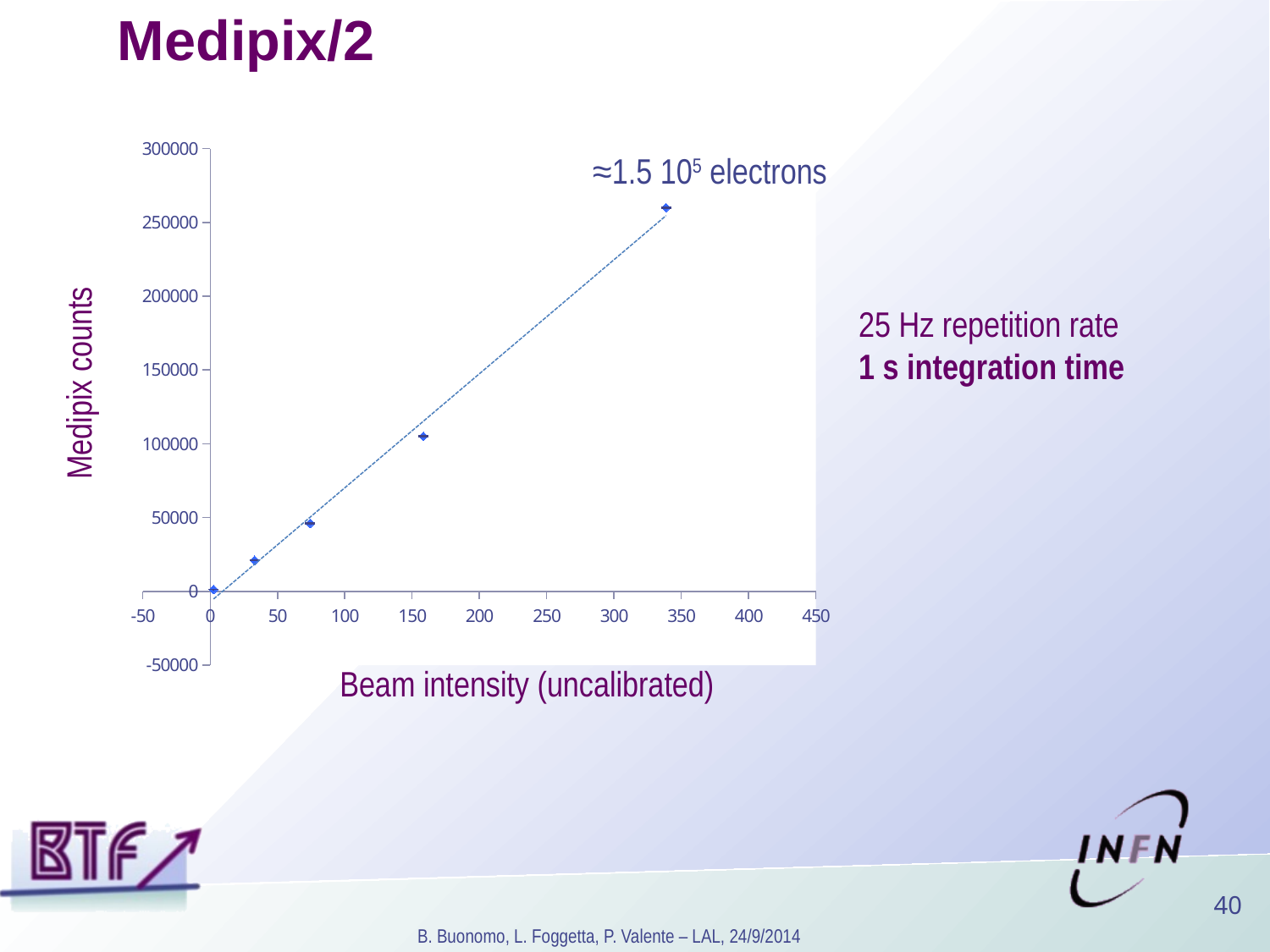
What kind of chart is shown on the slide? scatter chart Is the Medipix counts value for the rightmost data point greater or less than 200000? greater What is the label of the y axis? Medipix counts Is the Medipix counts value for the data point near beam intensity 160 greater or less than 150000? less How many data points are plotted on the chart? 5 Which data point has the lowest Medipix counts? the point at beam intensity 0 Is the Medipix counts value for the data point near beam intensity 75 greater or less than 100000? less What is the label of the x axis? Beam intensity (uncalibrated) Does the data point with the highest beam intensity also have the highest Medipix counts? yes Do the Medipix counts rise or fall as beam intensity increases along the x axis? rise